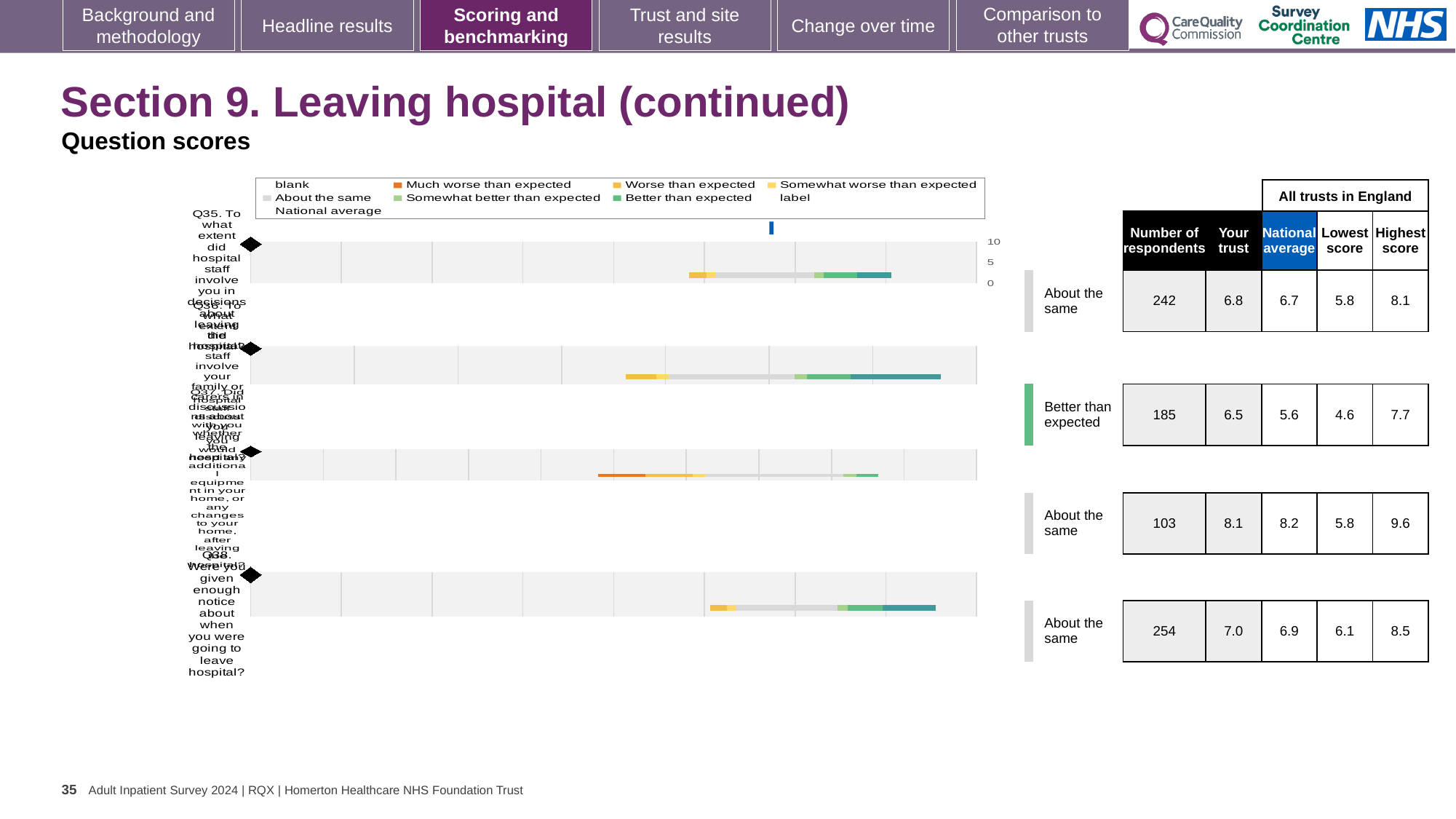
What is the difference between the highest score and the lowest score in the third row? 3.8 Which row has the lowest number of respondents? the third row (103) What kind of chart is shown on the slide? bar chart What is the number of respondents for Q35 (the first row)? 242 How many entries does the chart legend list? 9 What is the national average for the second row of the table? 5.6 In the second row, which is larger: the 'Your trust' score or the national average? Your trust Which row has the highest 'Your trust' score? the third row (8.1) What is the 'Your trust' score for Q38 (the last row)? 7.0 What is the title of the slide containing the chart? Section 9. Leaving hospital (continued) How many question bars are plotted in the chart? 4 What benchmark category is shown for the second row? Better than expected